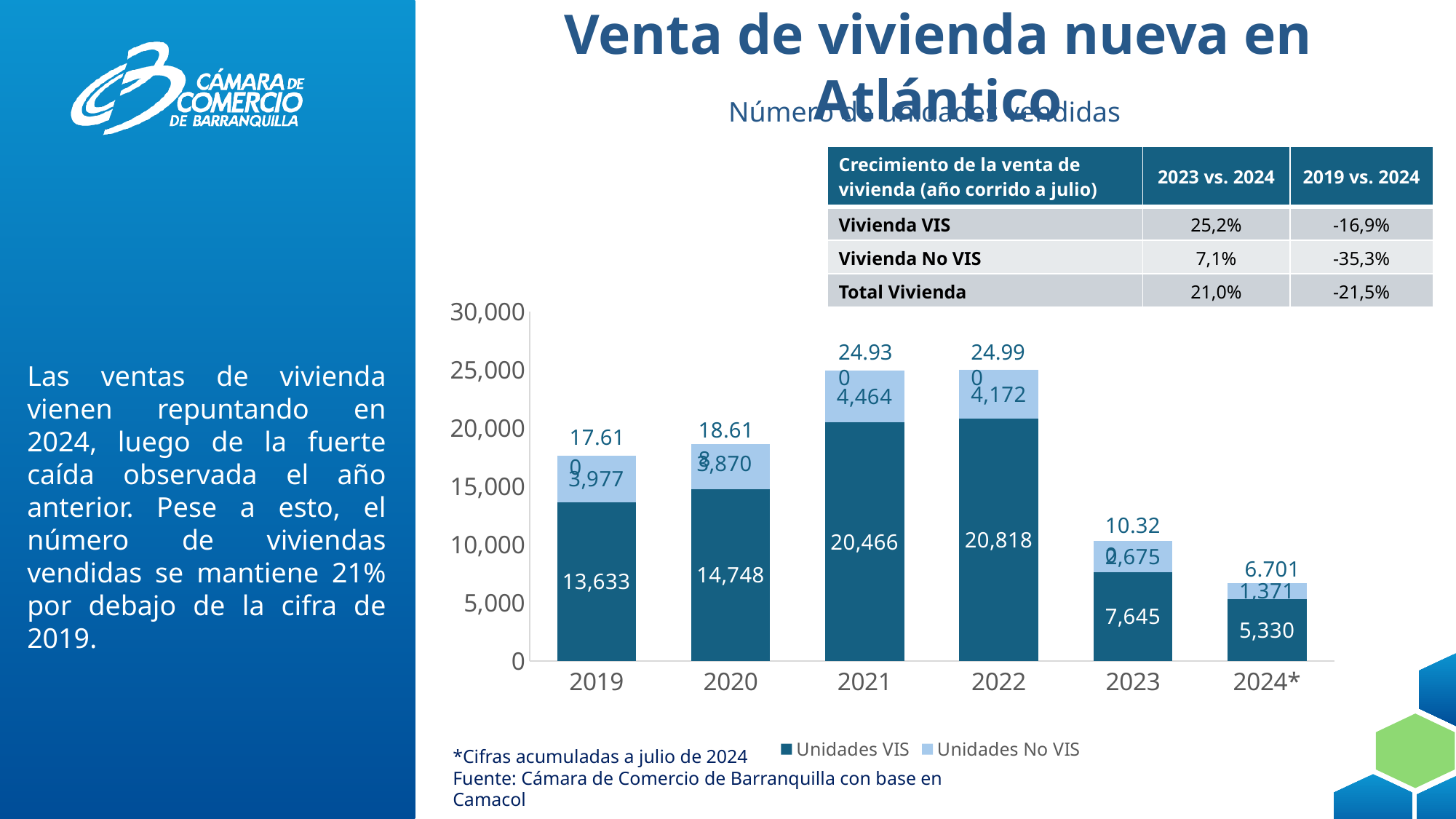
Which is larger: Unidades No VIS in 2019 or Unidades No VIS in 2020? 2019 How many series does the chart legend list? 2 Which series is shown in the darker blue colour in the chart? Unidades VIS Which year has the lowest value of Unidades No VIS? 2024* What is the total of the stacked bar for 2023 (Unidades VIS plus Unidades No VIS)? 10,320 How many years (categories) are shown on the x axis of the chart? 6 What is the difference between Unidades VIS in 2021 and in 2023? 12,821 Which year has the highest value of Unidades VIS? 2022 What is the value of Unidades VIS for 2024*? 5,330 What kind of chart is shown on the slide? Stacked bar chart What is the value of Unidades No VIS for 2021? 4,464 What is the value of Unidades VIS for 2022? 20,818